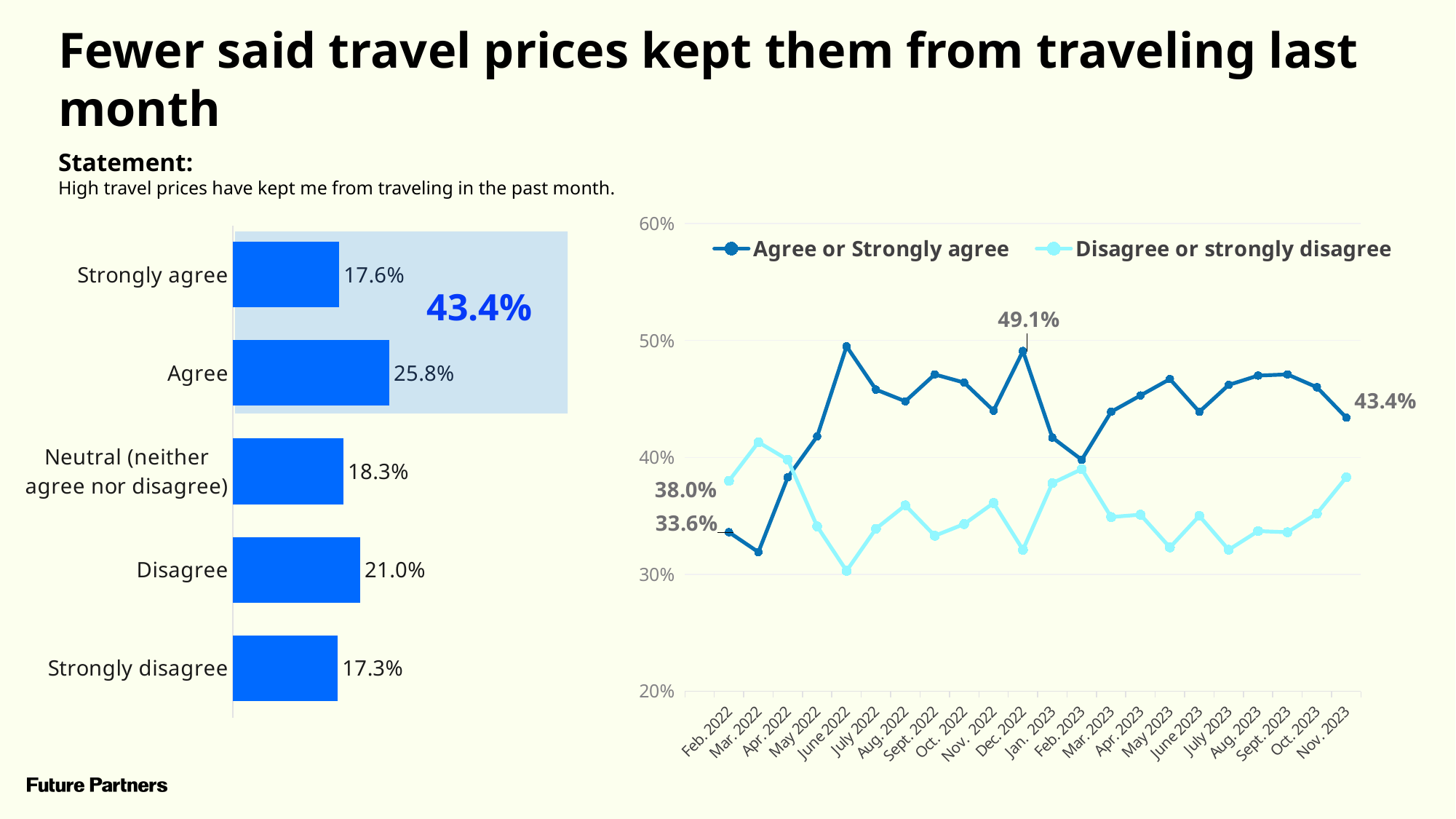
In the bar chart on the left, what is the combined share for Strongly agree and Agree shown in the highlighted box? 43.4% In the bar chart on the left, which category has the highest value? Agree In the bar chart on the left, which category has the lowest value? Strongly disagree In the line chart on the right, how many series does the legend list? 2 In the bar chart on the left, what is the difference between the Disagree and Strongly disagree values? 3.7% In the line chart on the right, what is the value for Agree or Strongly agree in Dec. 2022? 49.1% In the line chart on the right, is the value for Agree or Strongly agree in June 2022 greater or less than 40%? greater In the line chart on the right, what is the value for Disagree or strongly disagree in Feb. 2022? 38.0% In the bar chart on the left, what percentage of respondents said they strongly agree? 17.6% In the bar chart on the left, what is the value for Agree? 25.8% What type of chart is on the left side of the slide? Bar chart In the bar chart on the left, how many categories are shown? 5